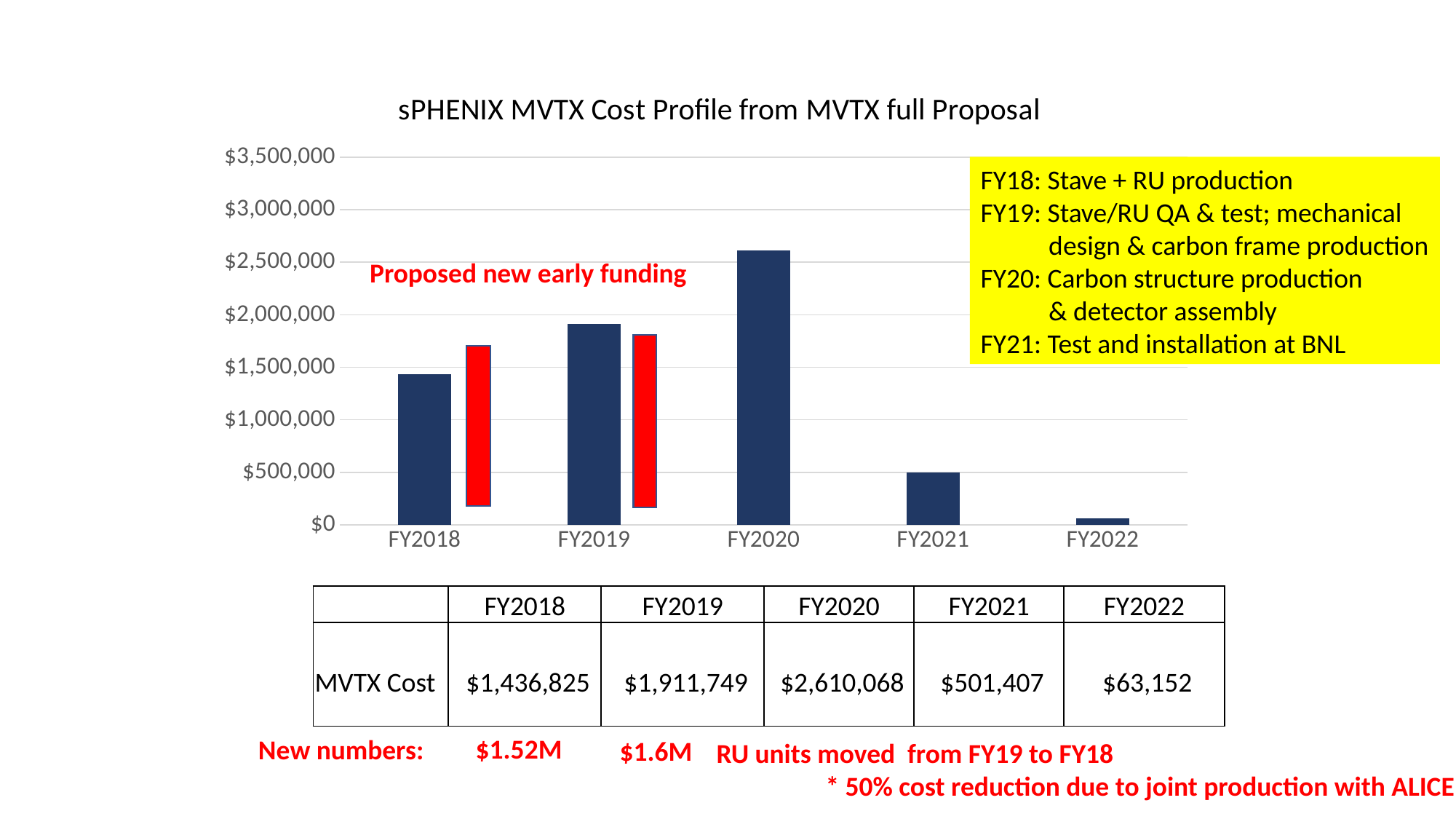
What is the MVTX Cost for FY2022? $63,152 What kind of chart is shown on the slide? bar chart Is the MVTX Cost for FY2021 greater or less than $1,000,000? less What is the difference between the MVTX Cost for FY2018 and FY2021? $935,418 From FY2020 to FY2022, do the MVTX Cost values rise or fall? fall What is the MVTX Cost for FY2020? $2,610,068 Which is larger, the MVTX Cost for FY2019 or for FY2018? FY2019 Which fiscal year has the highest MVTX Cost? FY2020 Which fiscal year has the lowest MVTX Cost? FY2022 How many fiscal years are shown on the x axis of the chart? 5 What is the MVTX Cost for FY2018? $1,436,825 What is the difference between the MVTX Cost for FY2020 and FY2019? $698,319